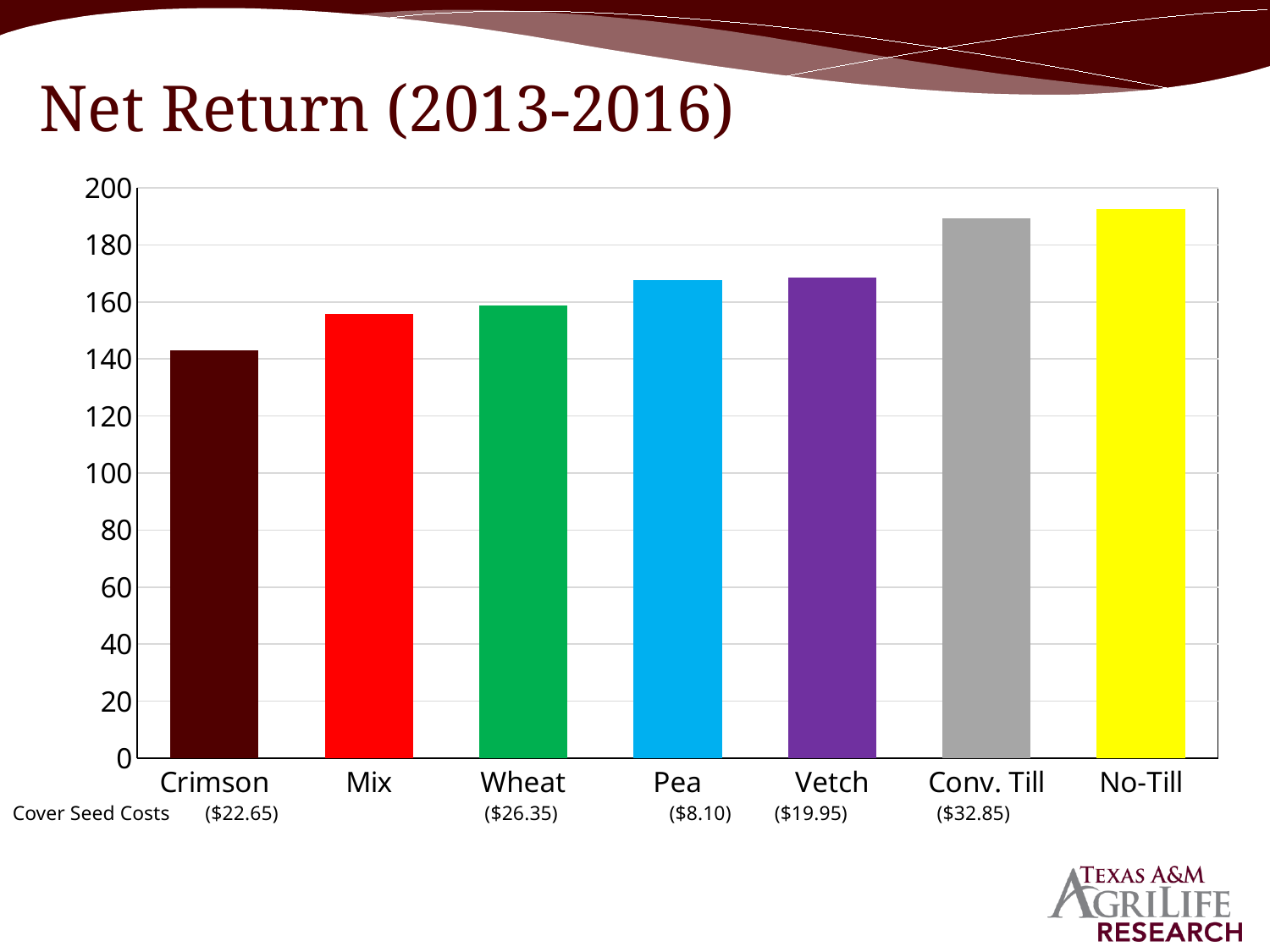
What is the title of the chart? Net Return (2013-2016) How many categories are shown on the x axis of the chart? 7 Is the value for Crimson greater or less than 160? less Is the value for Crimson greater or less than 120? greater What kind of chart is shown on the slide? bar chart Is the value for Mix greater or less than 140? greater What colour is the bar for No-Till? yellow Which is larger, the value for Crimson or the value for Conv. Till? Conv. Till Which category has the lowest net return? Crimson